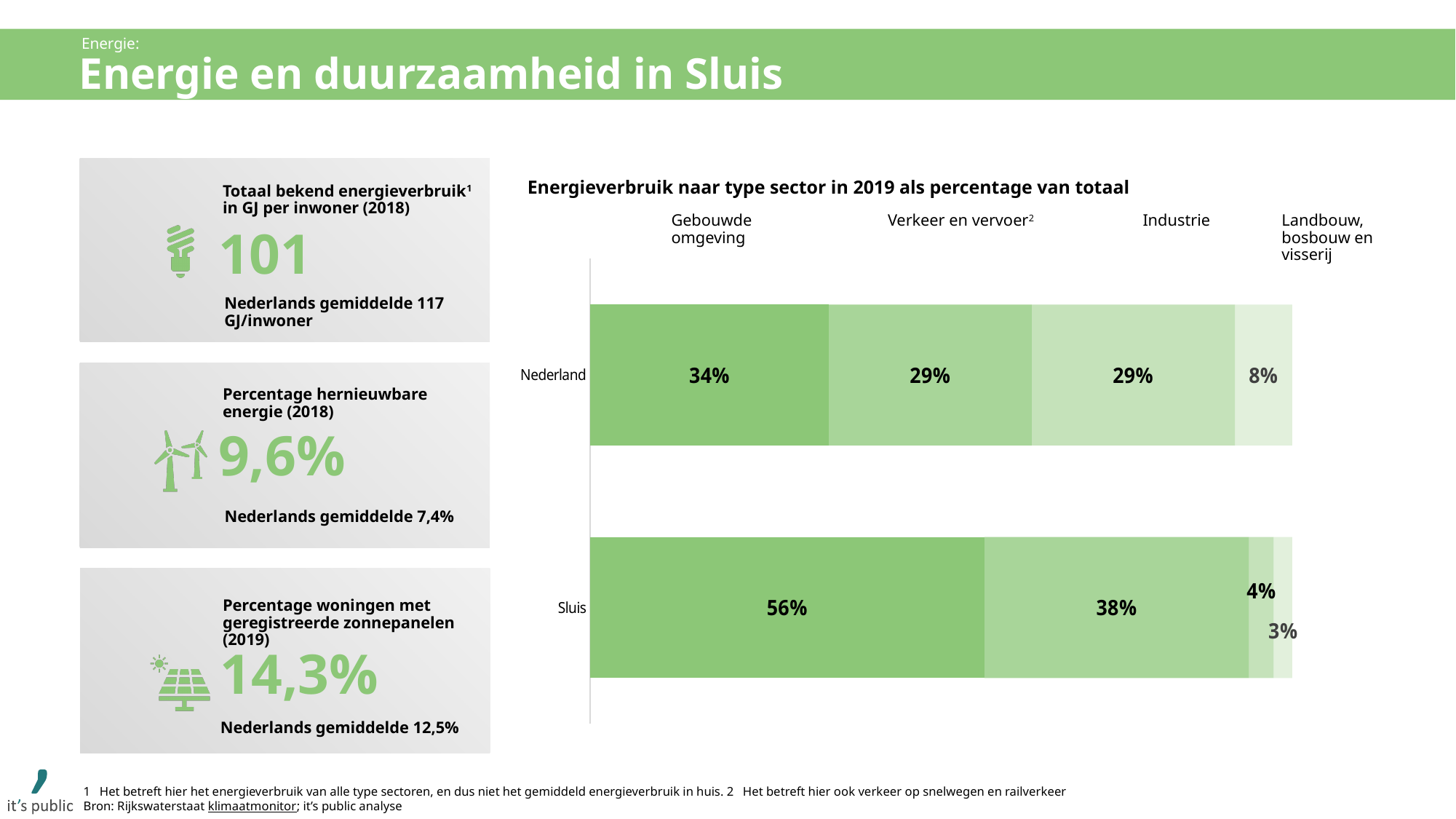
In the chart 'Energieverbruik naar type sector in 2019', what is the percentage for Verkeer en vervoer for Sluis? 38% How many bars (regions) are shown in the chart 'Energieverbruik naar type sector in 2019'? 2 In the chart 'Energieverbruik naar type sector in 2019', which sector has the largest share for Sluis? Gebouwde omgeving In the chart 'Energieverbruik naar type sector in 2019', what is the difference in percentage points between Gebouwde omgeving for Sluis and for Nederland? 22 In the chart 'Energieverbruik naar type sector in 2019', what is the percentage for Gebouwde omgeving for Nederland? 34% In the chart 'Energieverbruik naar type sector in 2019', what is the percentage for Industrie for Nederland? 29% What type of chart is shown under the title 'Energieverbruik naar type sector in 2019 als percentage van totaal'? Stacked bar chart In the chart 'Energieverbruik naar type sector in 2019', which has a larger share of Industrie: Nederland or Sluis? Nederland In the chart 'Energieverbruik naar type sector in 2019', what is the percentage for Landbouw, bosbouw en visserij for Nederland? 8% In the chart 'Energieverbruik naar type sector in 2019', what is the percentage for Gebouwde omgeving for Sluis? 56% How many sector categories are listed above the chart 'Energieverbruik naar type sector in 2019'? 4 In the chart 'Energieverbruik naar type sector in 2019', which sector has the smallest share for Nederland? Landbouw, bosbouw en visserij